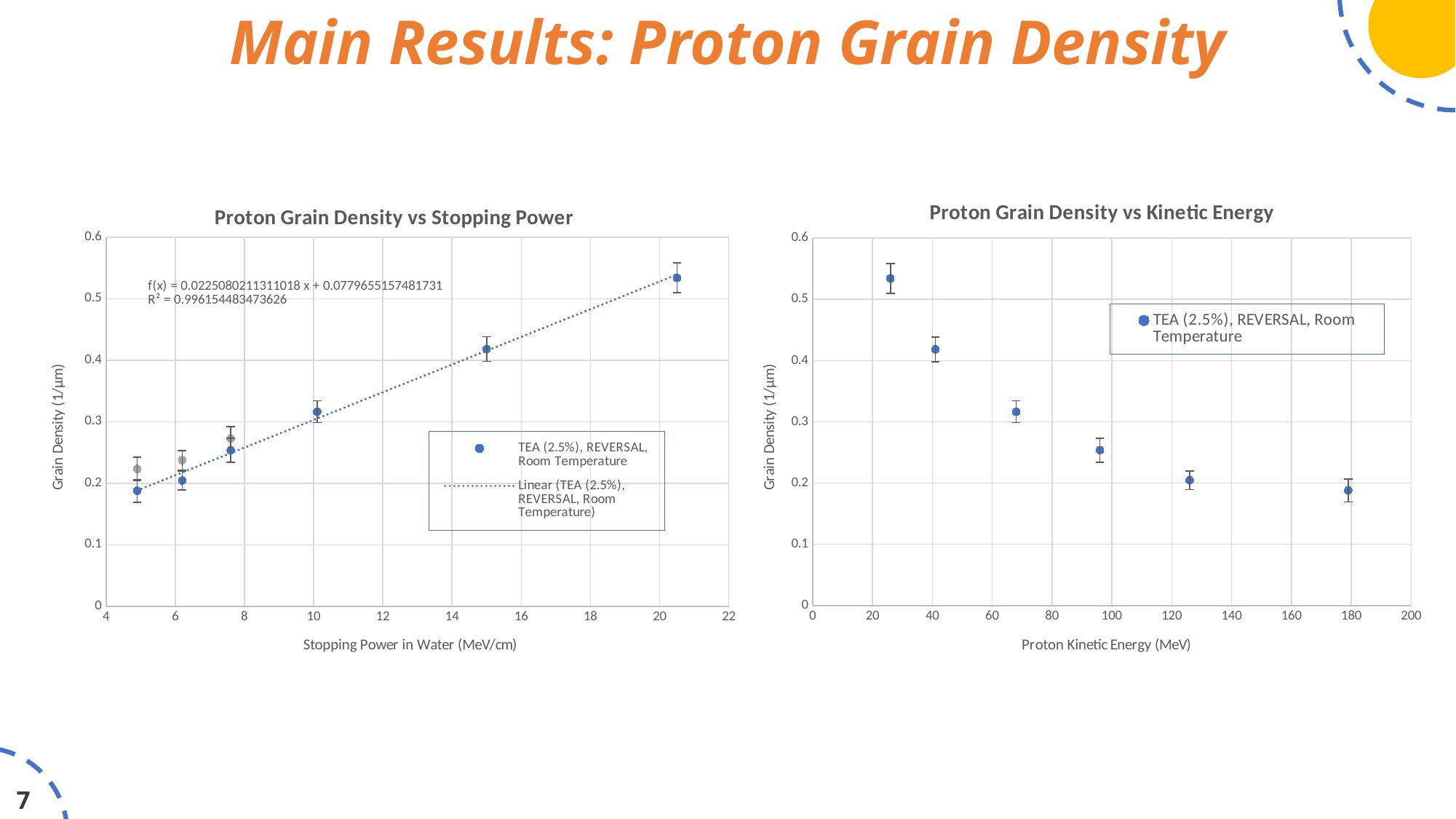
How many data points are plotted in the 'Proton Grain Density vs Kinetic Energy' chart? 6 In the 'Proton Grain Density vs Kinetic Energy' chart, does grain density rise or fall as proton kinetic energy increases? fall In the 'Proton Grain Density vs Kinetic Energy' chart, is the grain density at about 96 MeV greater or less than 0.3? less What R² value is printed on the 'Proton Grain Density vs Stopping Power' chart? 0.996154483473626 In the 'Proton Grain Density vs Stopping Power' chart, does grain density rise or fall as stopping power increases? rise How many entries does the legend of the 'Proton Grain Density vs Stopping Power' chart list? 2 In the 'Proton Grain Density vs Stopping Power' chart, is the grain density at the highest stopping power (about 20.5 MeV/cm) greater or less than 0.5? greater How many series does the legend of the 'Proton Grain Density vs Kinetic Energy' chart list? 1 What kind of chart is the 'Proton Grain Density vs Kinetic Energy' chart? scatter chart In the 'Proton Grain Density vs Kinetic Energy' chart, is the grain density at the lowest kinetic energy (about 26 MeV) greater or less than 0.5? greater In the 'Proton Grain Density vs Kinetic Energy' chart, which point has the highest grain density: the one at about 26 MeV or the one at about 180 MeV? the one at about 26 MeV